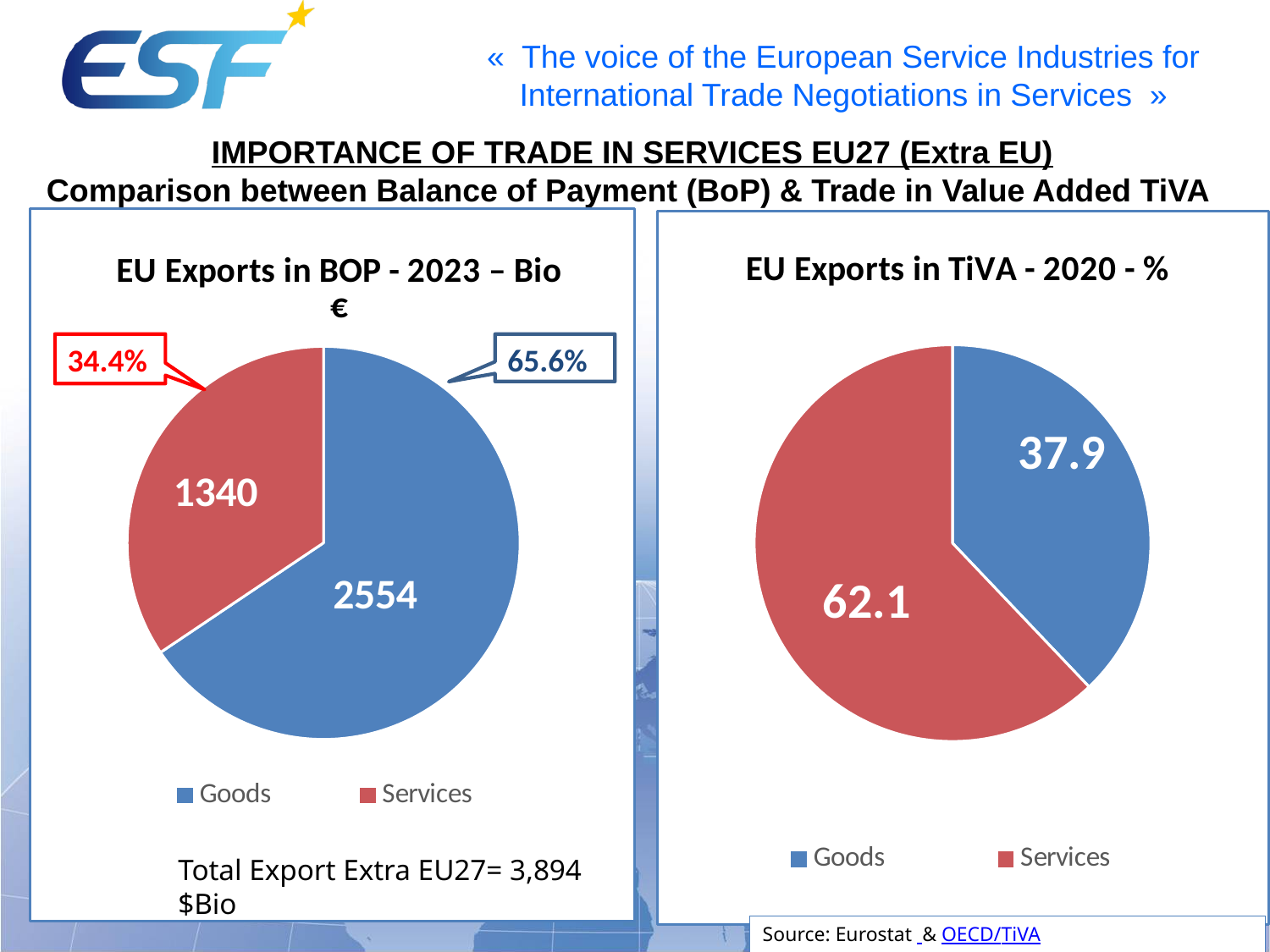
In the 'EU Exports in BOP - 2023' chart, which category is the largest? Goods In the 'EU Exports in BOP - 2023' chart, what percentage share is shown for Goods? 65.6% In the 'EU Exports in BOP - 2023' chart, what is the value for Goods? 2554 How many categories does the legend of the 'EU Exports in BOP - 2023' chart list? 2 In the 'EU Exports in BOP - 2023' chart, what is the difference between the Goods and Services values? 1214 In the 'EU Exports in TiVA - 2020' chart, what is the value for Services? 62.1 In the 'EU Exports in BOP - 2023' chart, what is the value for Services? 1340 In the 'EU Exports in TiVA - 2020' chart, which category is the smallest? Goods In the 'EU Exports in TiVA - 2020' chart, what is the value for Goods? 37.9 In the 'EU Exports in BOP - 2023' chart, what percentage share is shown for Services? 34.4% What type of chart is the 'EU Exports in TiVA - 2020' chart? Pie chart In the 'EU Exports in TiVA - 2020' chart, is the value for Goods or Services larger? Services